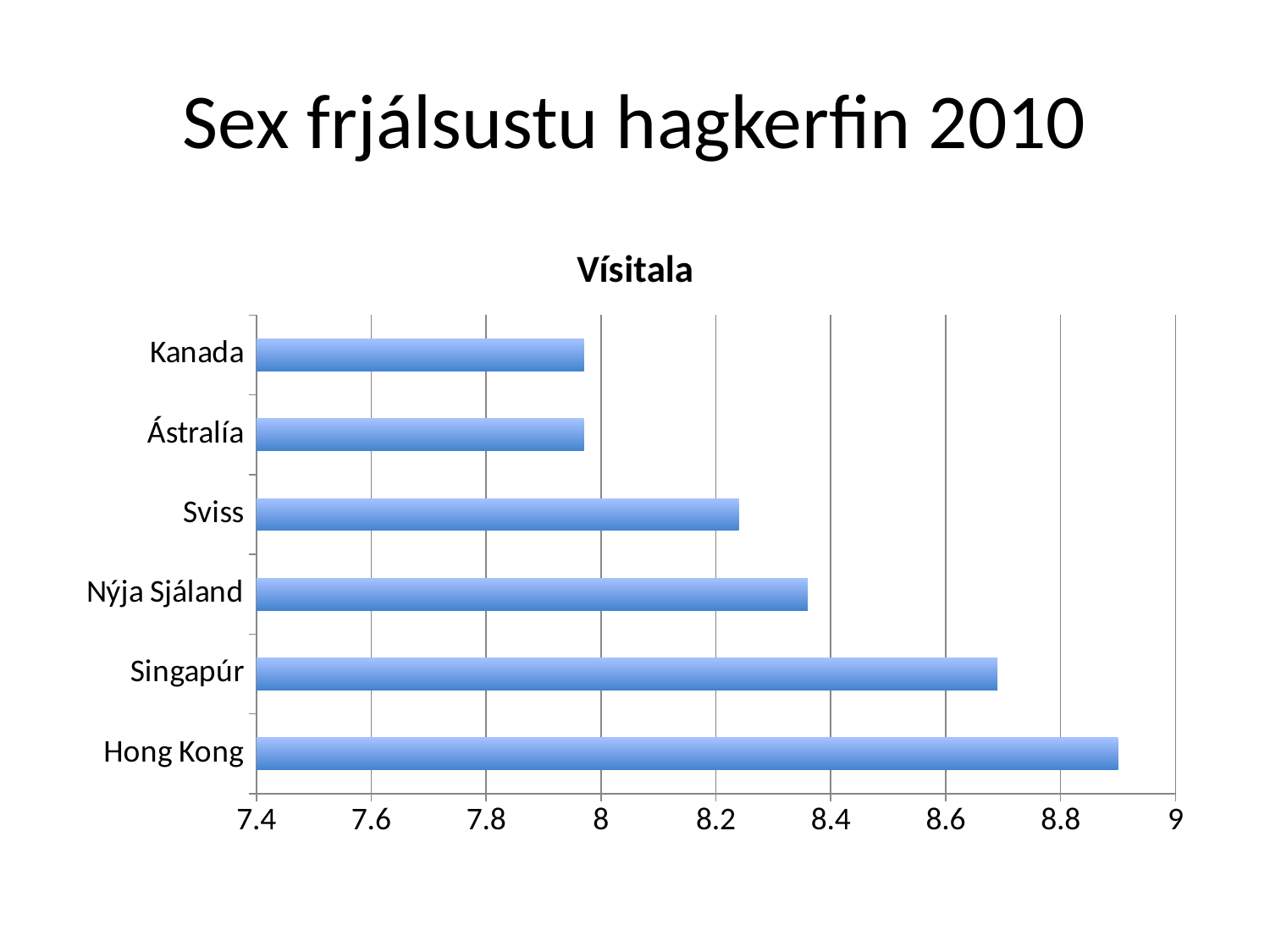
What is the lowest value shown on the horizontal axis? 7.4 Is the value for Hong Kong greater or less than 8.8? greater Is the value for Singapúr greater or less than 8.6? greater Is the value for Nýja Sjáland greater or less than 8.4? less What is the title of the chart? Vísitala Which country has the highest value in the chart? Hong Kong Which has a larger value, Singapúr or Nýja Sjáland? Singapúr Which has a larger value, Sviss or Ástralía? Sviss What kind of chart is shown on the slide? bar chart How many countries are shown in the chart? 6